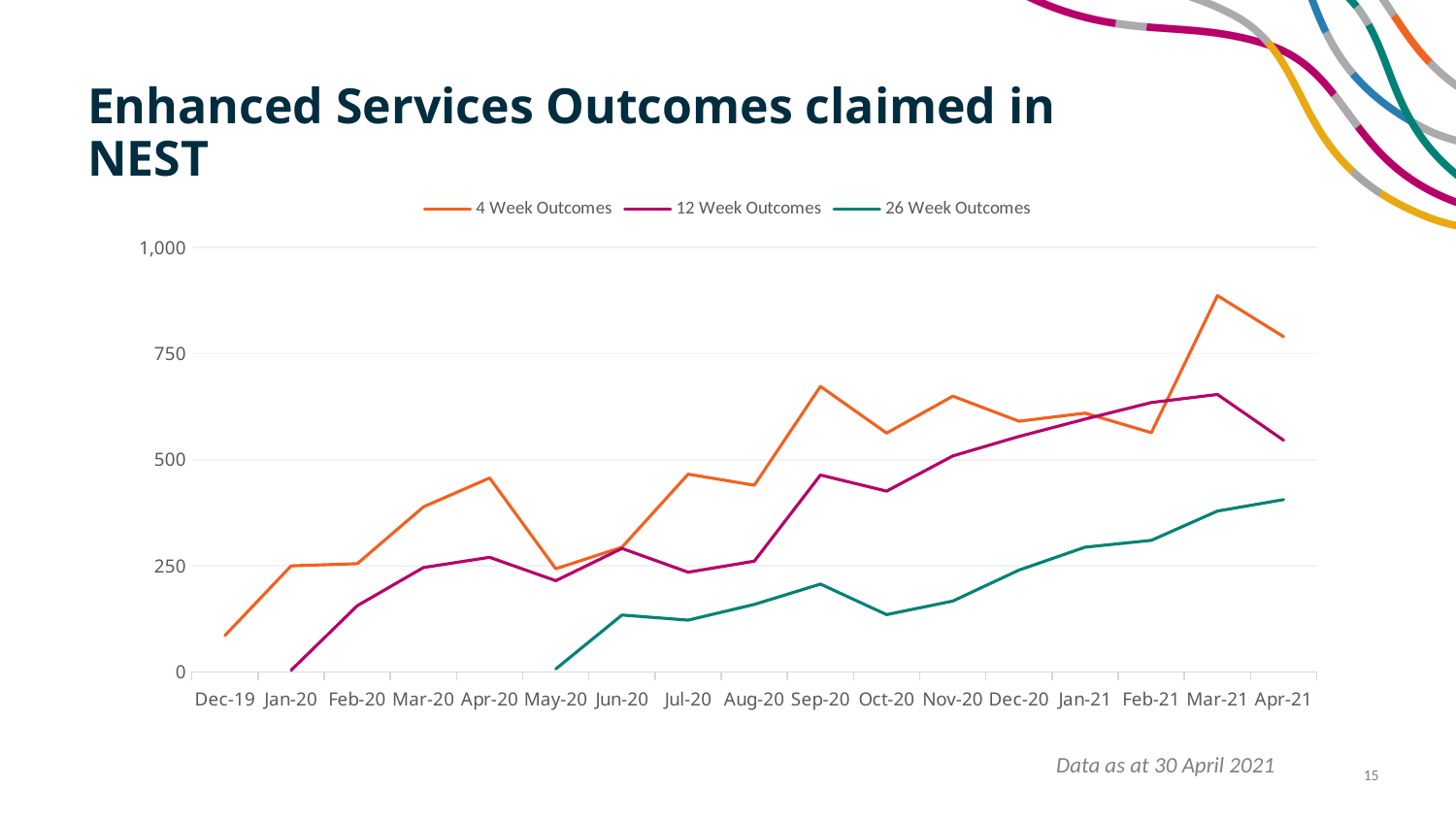
In which month is the 4 Week Outcomes series at its lowest value? Dec-19 How many months are shown along the x axis? 17 Is the value for 26 Week Outcomes in Apr-21 greater or less than 500? less What kind of chart is shown on the slide? Line chart What is the title of the chart on the slide? Enhanced Services Outcomes claimed in NEST Is the value for 4 Week Outcomes in Mar-21 greater or less than 750? greater In which month does the 4 Week Outcomes series reach its highest value? Mar-21 Is the value for 12 Week Outcomes in Mar-21 greater or less than 500? greater Does the 26 Week Outcomes series generally rise or fall from May-20 to Apr-21? Rise In Sep-20, which is larger: 4 Week Outcomes or 12 Week Outcomes? 4 Week Outcomes How many series does the legend list? 3